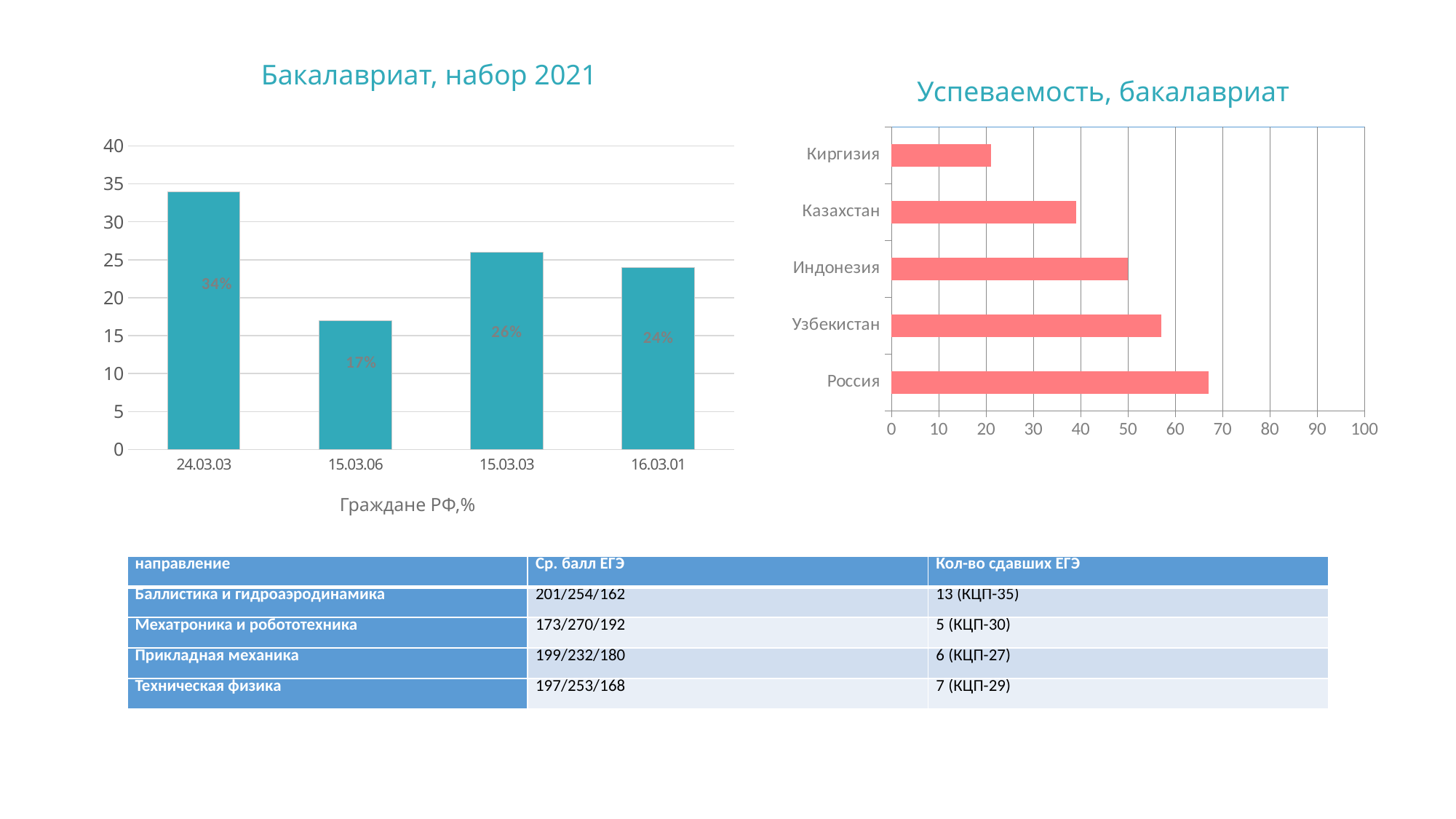
In the chart titled "Успеваемость, бакалавриат", which is larger, the value for Казахстан or the value for Индонезия? Индонезия In the chart titled "Бакалавриат, набор 2021", which category has the lowest value? 15.03.06 In the chart titled "Бакалавриат, набор 2021", which category has the highest value? 24.03.03 In the chart titled "Бакалавриат, набор 2021", what is the value for 24.03.03? 34% In the chart titled "Успеваемость, бакалавриат", which country has the lowest value? Киргизия In the chart titled "Успеваемость, бакалавриат", is the value for Узбекистан greater or less than 50? greater What kind of chart is the one titled "Успеваемость, бакалавриат"? bar chart In the chart titled "Бакалавриат, набор 2021", how many categories are shown on the x axis? 4 In the chart titled "Бакалавриат, набор 2021", what is the difference between the values for 15.03.03 and 16.03.01? 2% In the chart titled "Бакалавриат, набор 2021", what is the value for 15.03.06? 17% In the chart titled "Успеваемость, бакалавриат", which country has the highest value? Россия